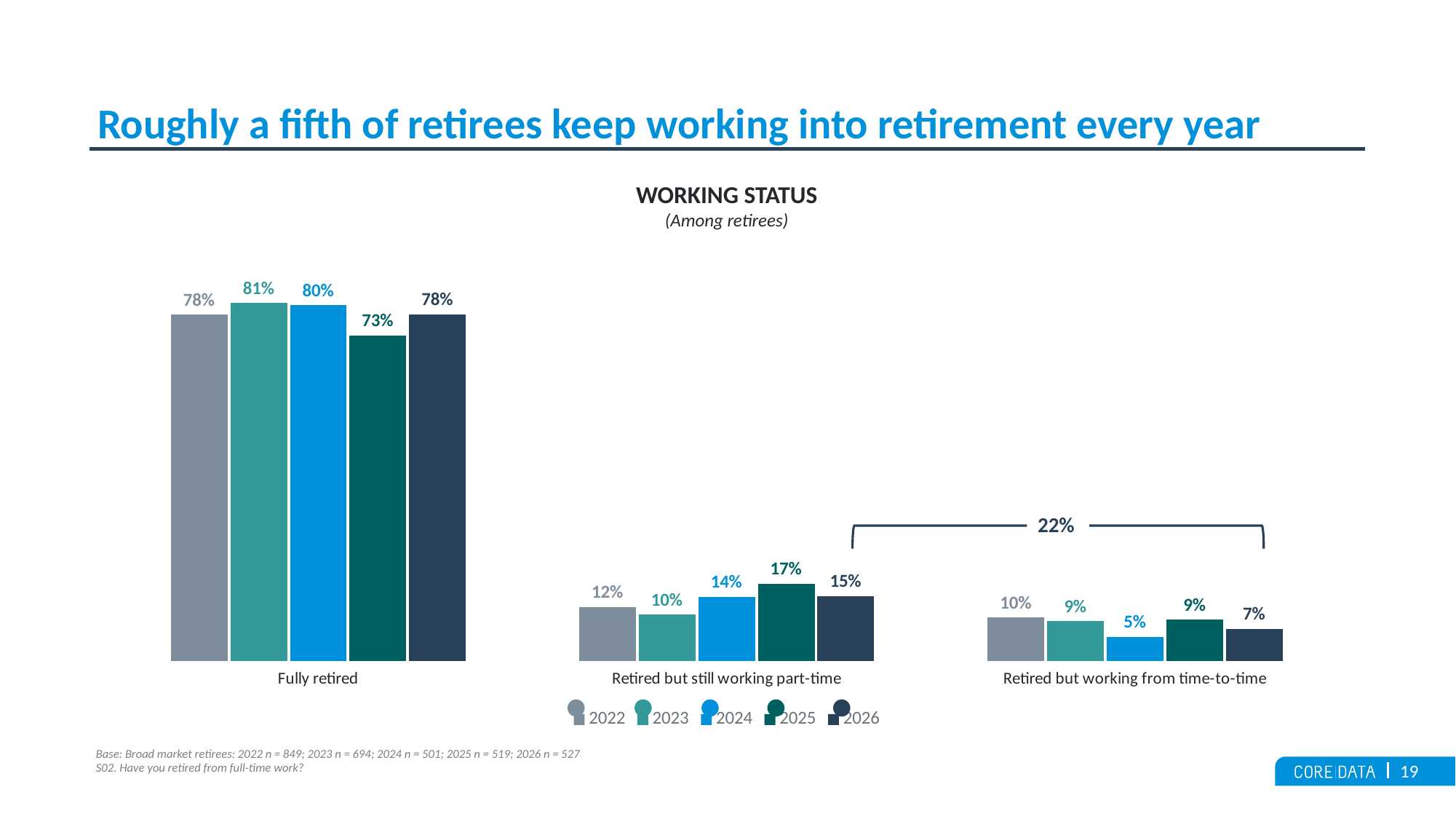
Which year had the highest share of retirees who were fully retired? 2023 What is the title of the chart? WORKING STATUS (Among retirees) What kind of chart is shown on the slide? Bar chart Which year had the lowest share of retirees who were retired but working from time-to-time? 2024 What percentage of retirees were retired but working from time-to-time in 2026? 7% What percentage of retirees were fully retired in 2025? 73% What is the combined 2026 value for the two 'retired but working' categories, as shown by the bracket on the chart? 22% How many categories are shown on the x axis of the chart? 3 What is the difference between the 2023 and 2025 values for fully retired? 8 percentage points How many series does the legend list? 5 Which is larger: the 2022 value for retired but still working part-time or the 2023 value for the same category? 2022 What percentage of retirees were retired but still working part-time in 2024? 14%